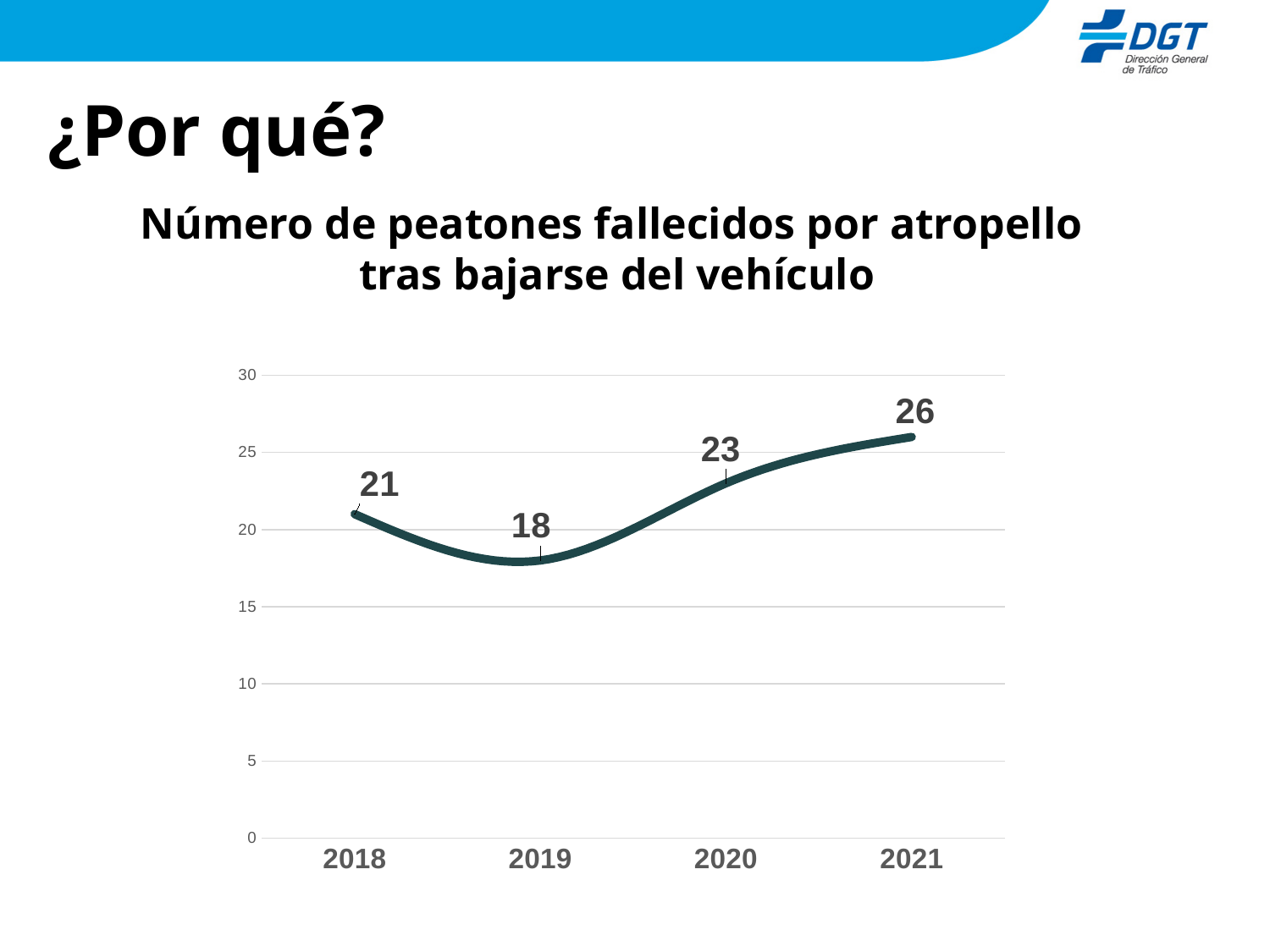
How many years are shown on the x axis? 4 What is the value for 2021? 26 What is the value for 2018? 21 Is the value for 2021 greater or less than 25? greater Which year has the highest value? 2021 Do the values rise or fall from 2019 to 2021? rise What kind of chart is shown on the slide? line chart What is the value for 2020? 23 What is the value for 2019? 18 What is the difference between the values for 2021 and 2018? 5 Which year has the lowest value? 2019 Which is larger, the value for 2020 or the value for 2018? 2020